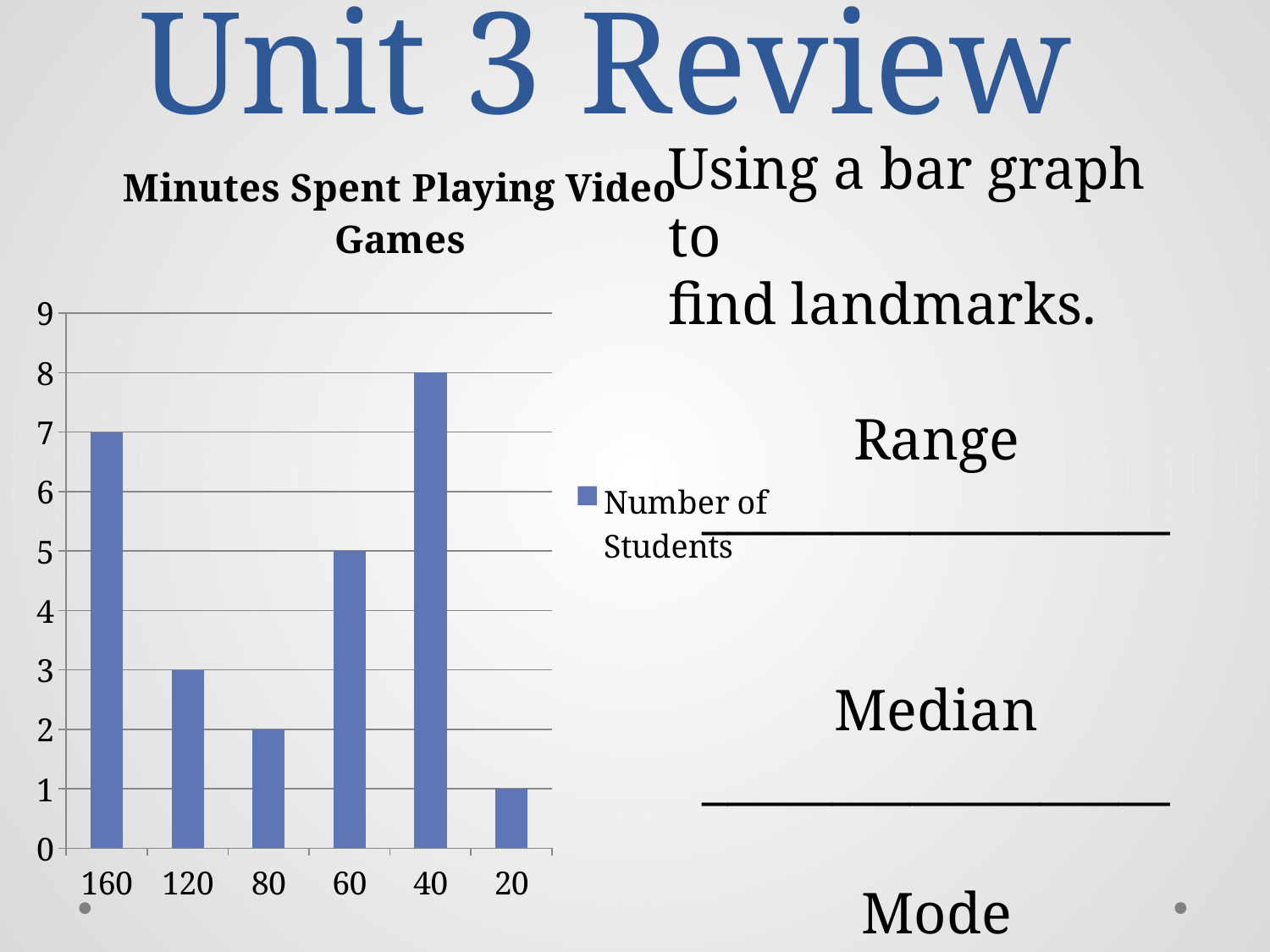
What is the difference between the number of students for 40 and for 120? 5 What is the number of students for the 160 category? 7 What is the name of the series shown in the legend? Number of Students How many series does the chart legend list? 1 What is the number of students for the 40 category? 8 How many categories are shown on the x axis of the chart? 6 What is the number of students for the 20 category? 1 Which category has the highest number of students? 40 What kind of chart is shown on the slide? bar chart Which has more students, the 60 category or the 80 category? 60 What is the title of the chart? Minutes Spent Playing Video Games Which category has the lowest number of students? 20